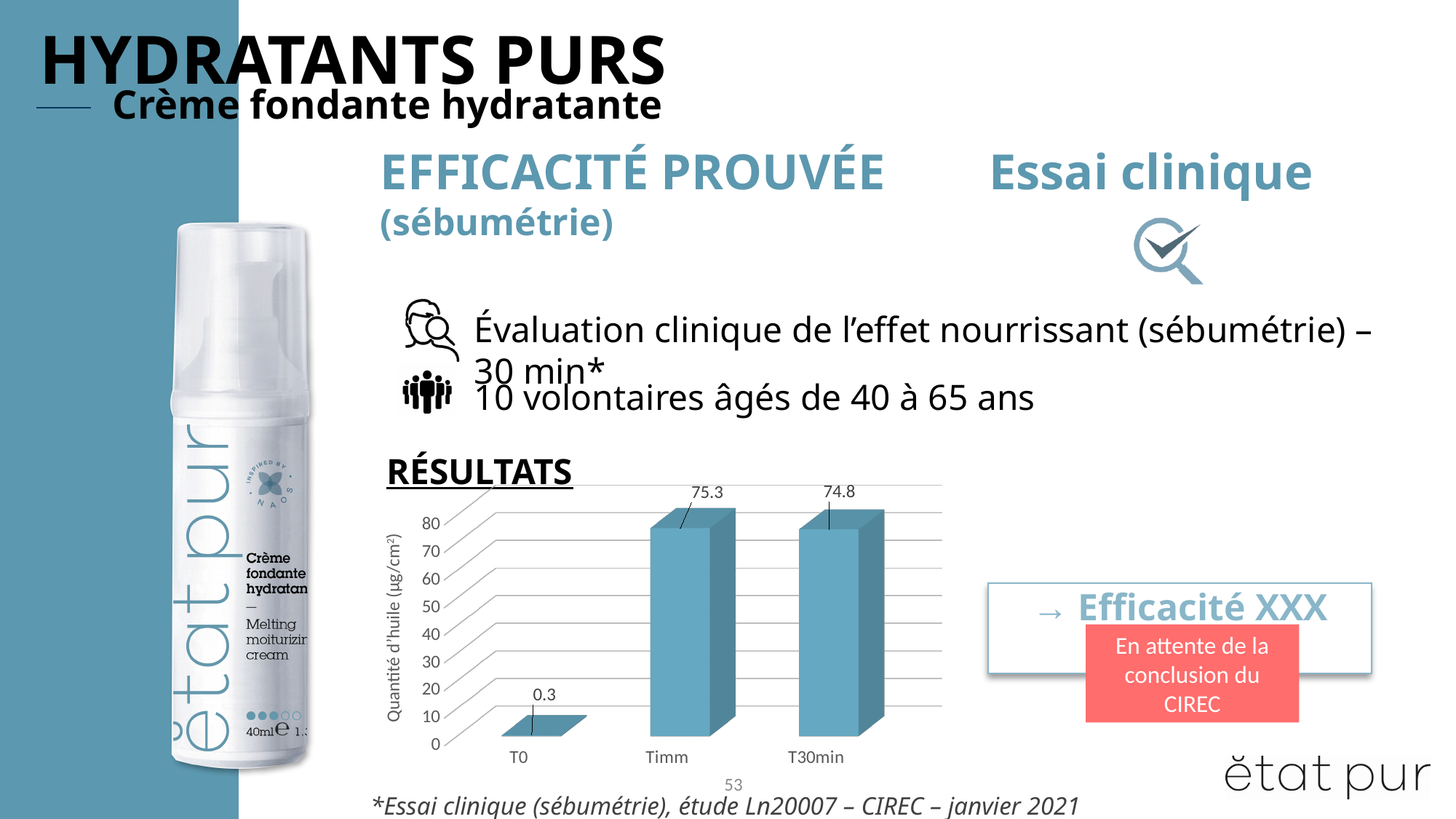
What is the value for T30min? 74.8 Which category has the highest value? Timm What kind of chart is shown? bar chart What is the value for Timm? 75.3 What is the value for T0? 0.3 Is the value for T30min greater or less than 70? greater Which is larger, the value for T30min or the value for T0? T30min How many categories are shown on the x axis? 3 What is the difference between the values for Timm and T30min? 0.5 What is the difference between the values for Timm and T0? 75.0 Which category has the lowest value? T0 What is the label of the vertical axis? Quantité d'huile (µg/cm²)